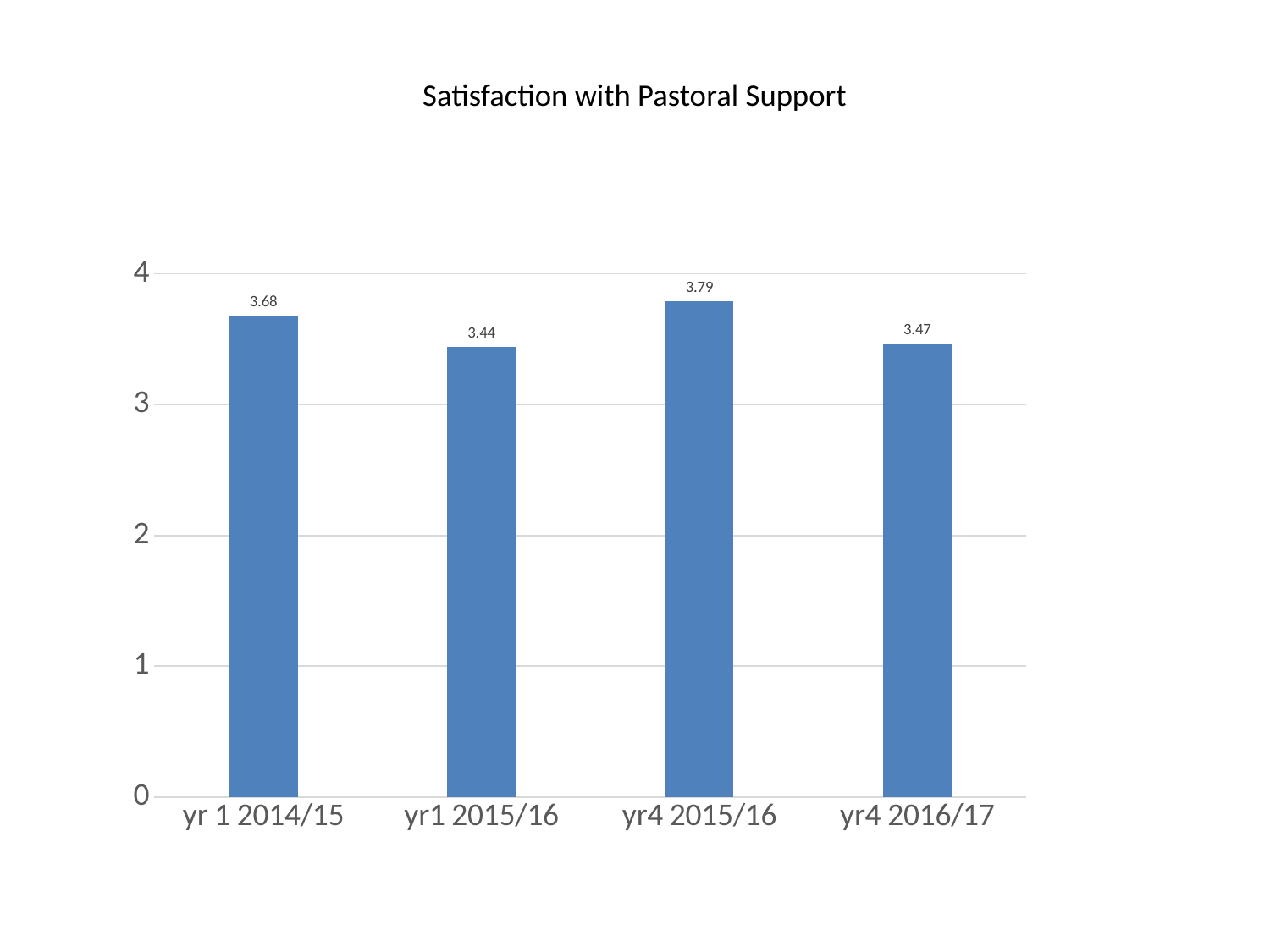
What is the value for yr1 2015/16? 3.44 Which category has the lowest value? yr1 2015/16 How many categories are shown on the x axis? 4 Is the value for yr1 2015/16 greater or less than 3? greater What is the value for yr 1 2014/15? 3.68 Which category has the highest value? yr4 2015/16 What is the value for yr4 2016/17? 3.47 What is the difference between the values for yr 1 2014/15 and yr4 2016/17? 0.21 Which is larger, the value for yr 1 2014/15 or the value for yr4 2016/17? yr 1 2014/15 What is the difference between the values for yr4 2015/16 and yr1 2015/16? 0.35 What is the value for yr4 2015/16? 3.79 What kind of chart is shown on the slide? bar chart